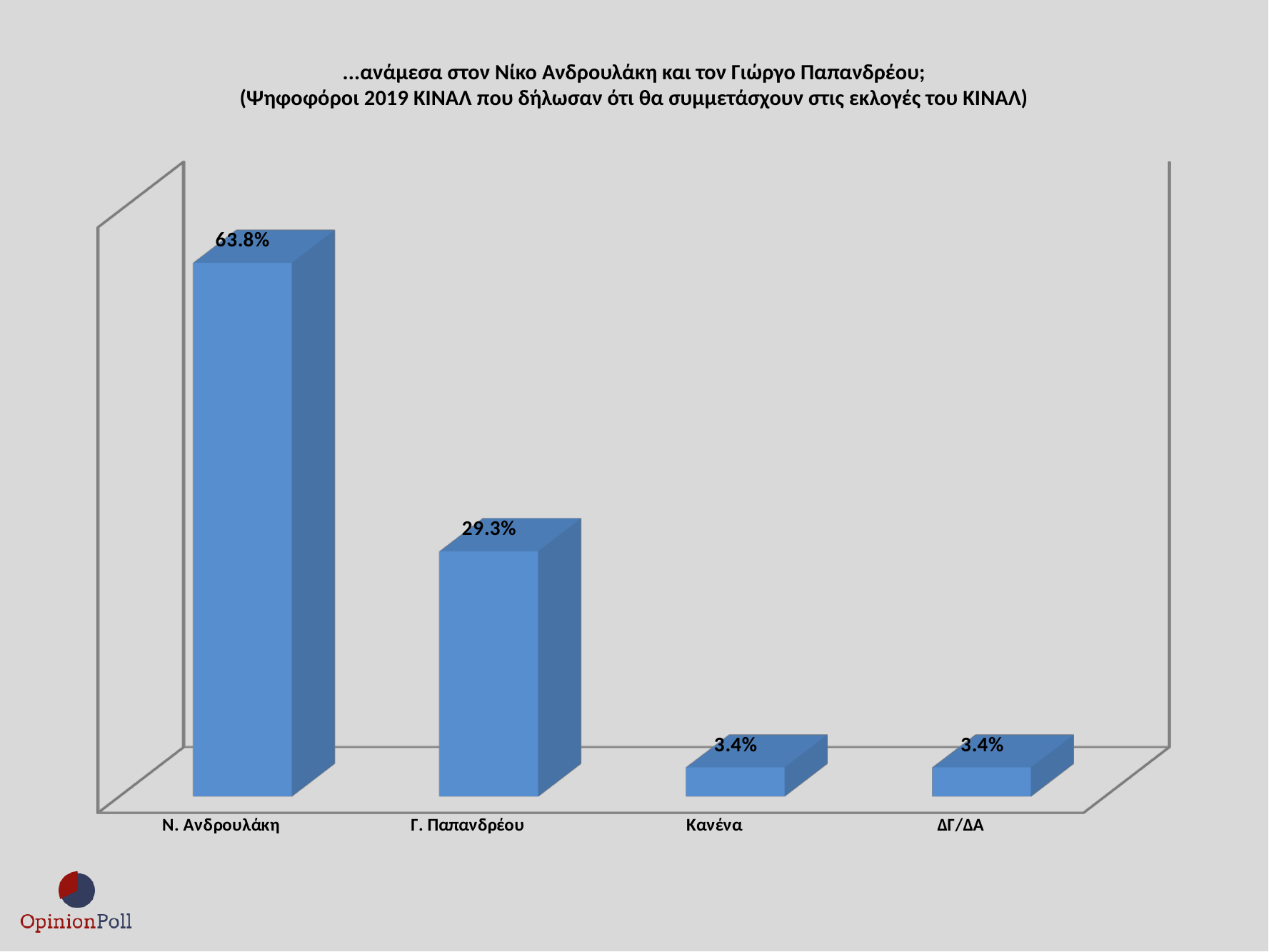
Which category has the highest value? Ν. Ανδρουλάκη Which is larger, the value for Γ. Παπανδρέου or the value for Κανένα? Γ. Παπανδρέου What colour are the bars in the chart? Blue What is the difference between the values for Ν. Ανδρουλάκη and Γ. Παπανδρέου? 34.5% What is the value for Κανένα? 3.4% What is the difference between the values for Γ. Παπανδρέου and ΔΓ/ΔΑ? 25.9% What is the value for Γ. Παπανδρέου? 29.3% What is the label of the third category from the left? Κανένα What kind of chart is shown on the slide? Bar chart How many categories are shown on the chart? 4 What is the value for ΔΓ/ΔΑ? 3.4% What is the value for Ν. Ανδρουλάκη? 63.8%